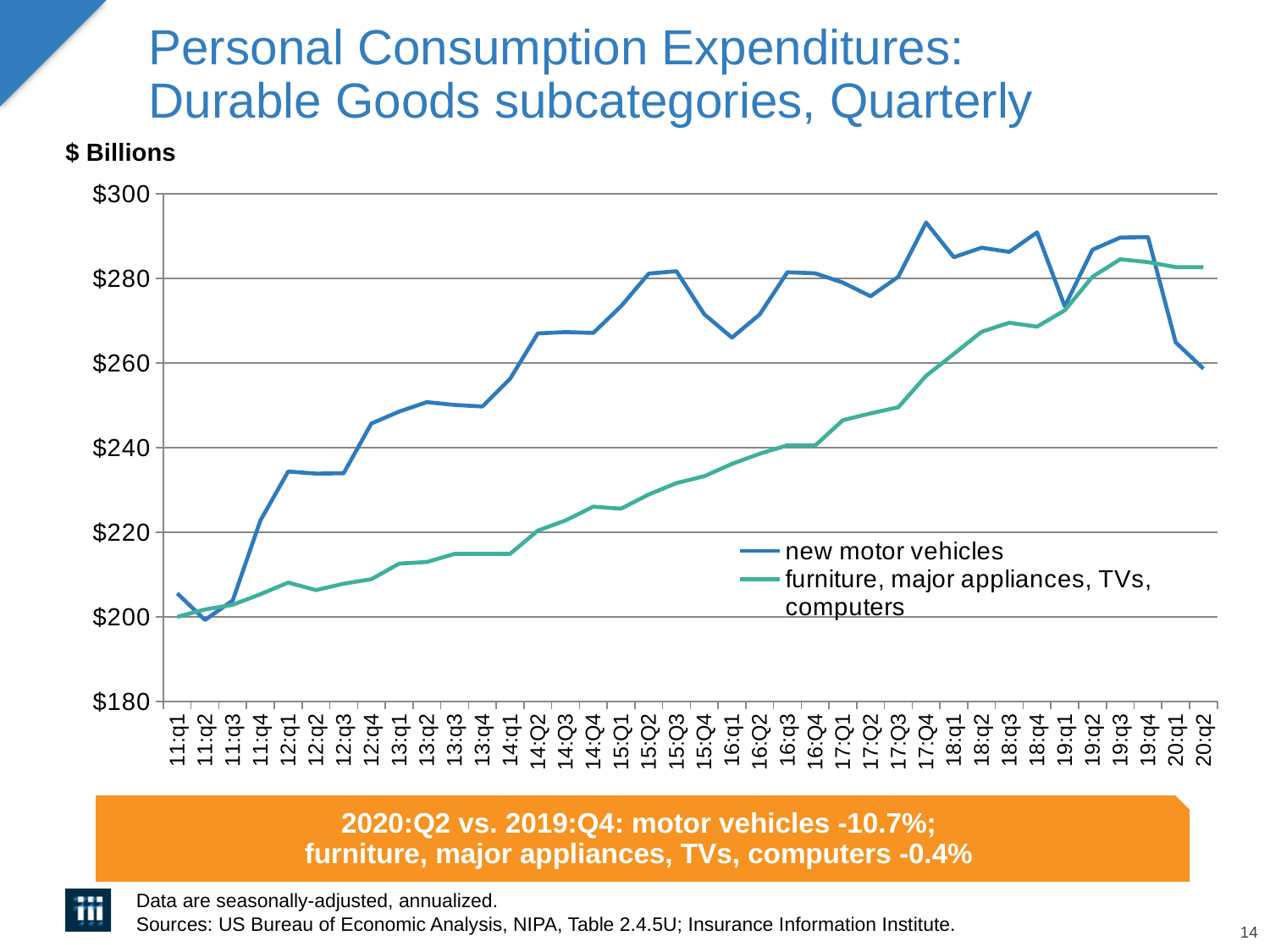
How many quarterly points are plotted along the x axis? 38 Is the value for new motor vehicles in 12:q1 greater or less than $220? greater What unit is shown above the y axis of the chart? $ Billions In 20:q2, which series has the larger value: new motor vehicles or furniture, major appliances, TVs, computers? furniture, major appliances, TVs, computers What kind of chart is shown on the slide? line chart Is the value for furniture, major appliances, TVs, computers in 13:q1 greater or less than $220? less Does the furniture, major appliances, TVs, computers series generally rise or fall from 11:q1 to 19:q3? rise In 15:Q2, which series has the larger value: new motor vehicles or furniture, major appliances, TVs, computers? new motor vehicles In which quarter is the new motor vehicles series at its lowest? 11:q2 Is the value for new motor vehicles in 20:q2 greater or less than $280? less How many series does the legend list? 2